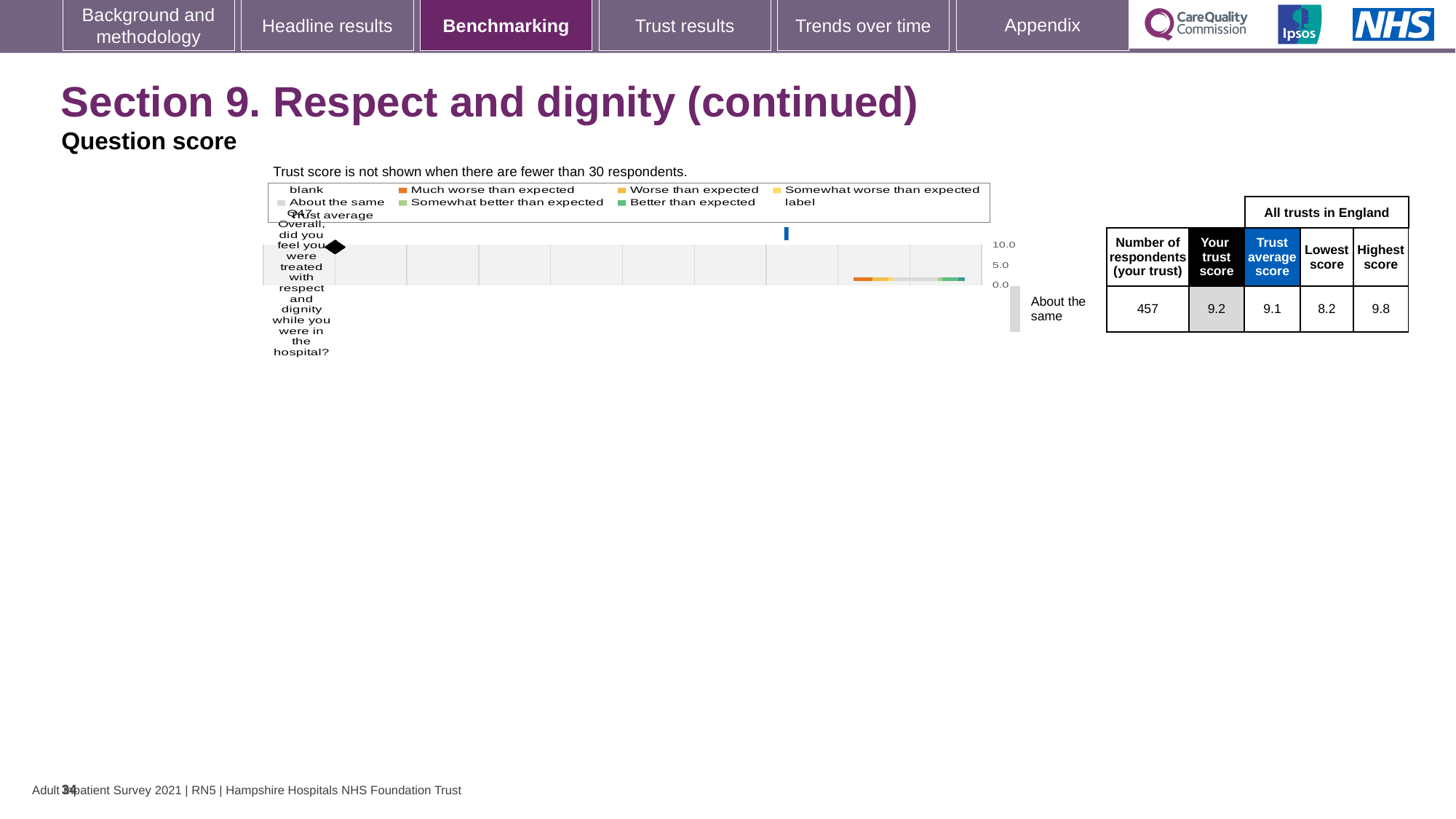
What is the difference between the highest score and the lowest score for Q47? 1.6 How many respondents from the trust answered Q47? 457 What is the lowest score among all trusts in England for Q47? 8.2 What is the highest tick value shown on the chart's score axis? 10.0 What is the highest score among all trusts in England for Q47? 9.8 Which benchmark category is Q47 placed in? About the same What kind of chart is shown on the slide for Q47? bar chart How many survey questions are plotted on the chart? 1 What is the trust average score for Q47? 9.1 Which is larger for Q47: your trust score or the trust average score? your trust score What is the trust score for Q47 (treated with respect and dignity)? 9.2 What is the difference between your trust score and the trust average score for Q47? 0.1